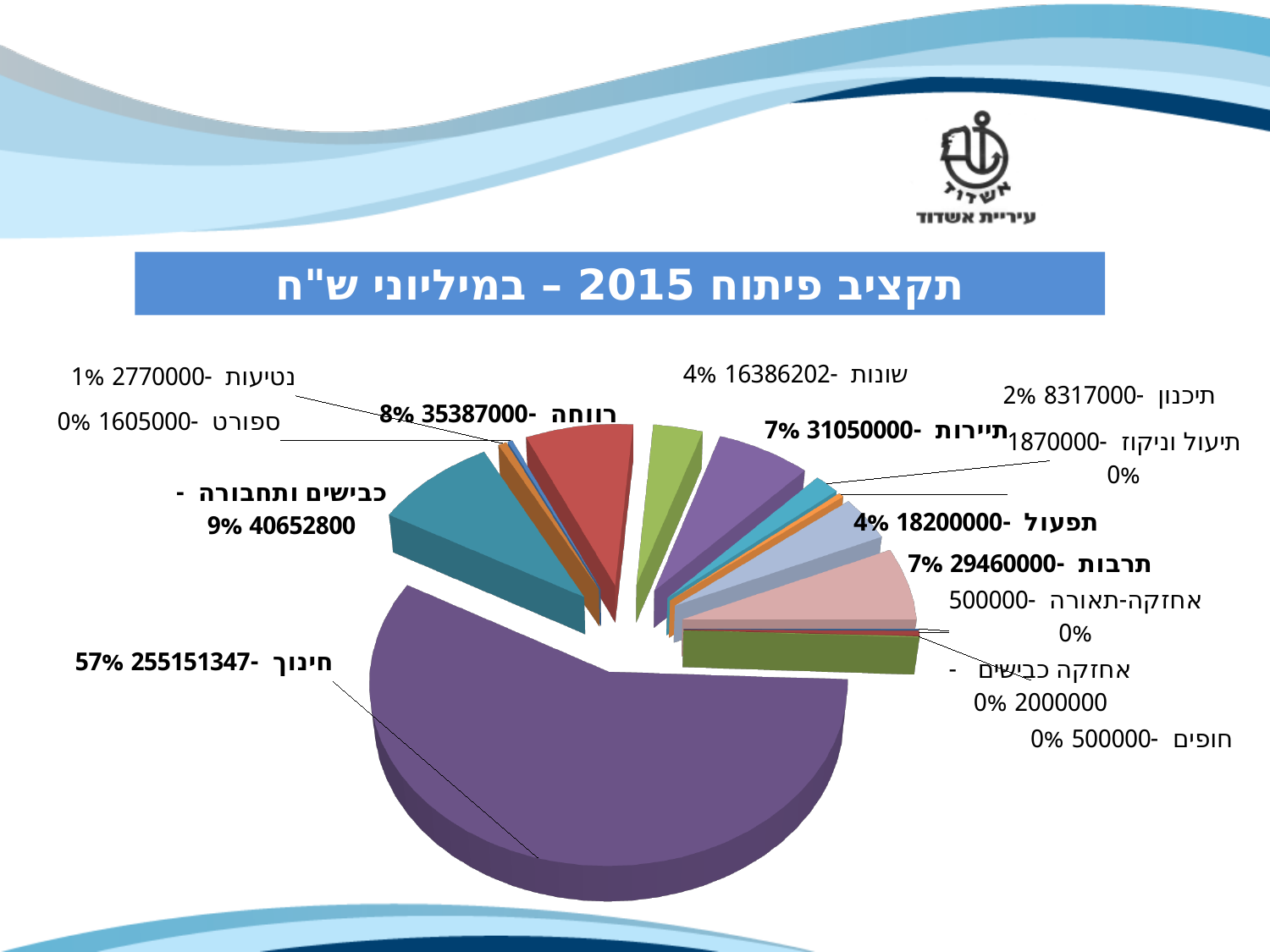
Which category has the largest slice of the pie? חינוך What is the value shown for כבישים ותחבורה? 40652800 What is the value shown for חינוך? 255151347 What is the value shown for תיירות? 31050000 What percentage share of the pie does חינוך have? 57% What is the title of the chart on the slide? תקציב פיתוח 2015 – במיליוני ש"ח What percentage share of the pie does רווחה have? 8% What kind of chart is shown on the slide? pie chart What is the difference between the values for תיירות and תרבות? 1590000 Which is larger, the value for רווחה or the value for תיירות? רווחה How many categories are labelled on the pie chart? 14 What is the value shown for שונות? 16386202